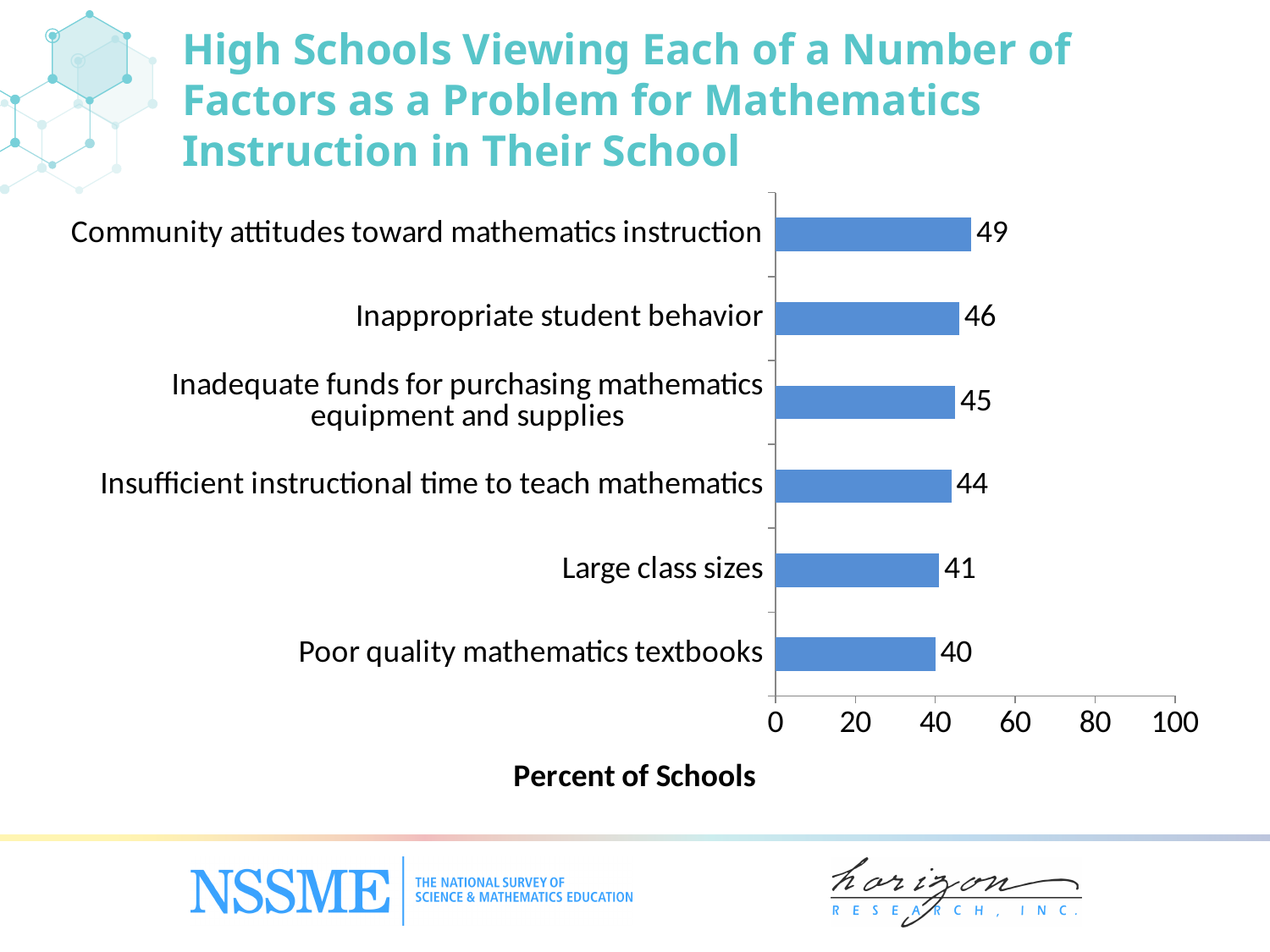
How many factors are shown in the chart? 6 Which is larger: the value for Inappropriate student behavior or the value for Large class sizes? Inappropriate student behavior What percent of high schools view community attitudes toward mathematics instruction as a problem? 49 What is the difference between the values for Inappropriate student behavior and Large class sizes? 5 What is the value for Insufficient instructional time to teach mathematics? 44 What is the value for Large class sizes? 41 What is the label of the horizontal axis? Percent of Schools What is the difference between the values for Community attitudes toward mathematics instruction and Poor quality mathematics textbooks? 9 What kind of chart is shown on the slide? Bar chart Which factor has the lowest percent of schools viewing it as a problem? Poor quality mathematics textbooks Which factor has the highest percent of schools viewing it as a problem? Community attitudes toward mathematics instruction What is the value for Poor quality mathematics textbooks? 40